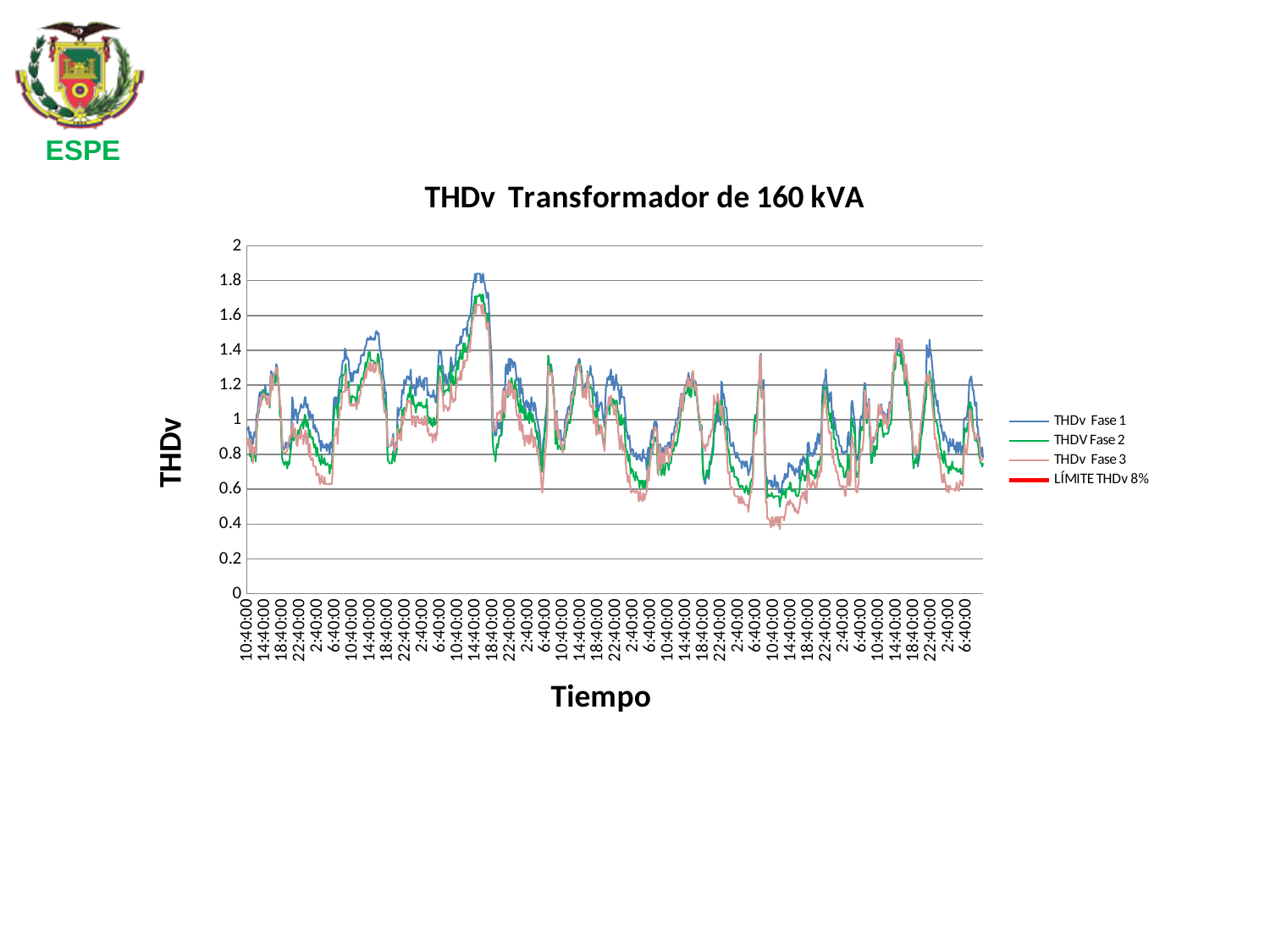
What kind of chart is shown on the slide? line chart How many entries does the chart's legend list? 4 What is the highest tick value shown on the vertical axis? 2 What is the first time label shown on the horizontal axis? 10:40:00 What is the label of the vertical axis? THDv Which series reaches the highest peak on the chart? THDv Fase 1 Is the lowest point of the THDv Fase 1 line greater or less than 0.4? greater What is the title of the chart? THDv Transformador de 160 kVA Is the lowest point of the THDv Fase 3 line greater or less than 0.6? less Is the highest peak of the THDv Fase 1 line greater or less than 1.6? greater Which series drops to the lowest value on the chart? THDv Fase 3